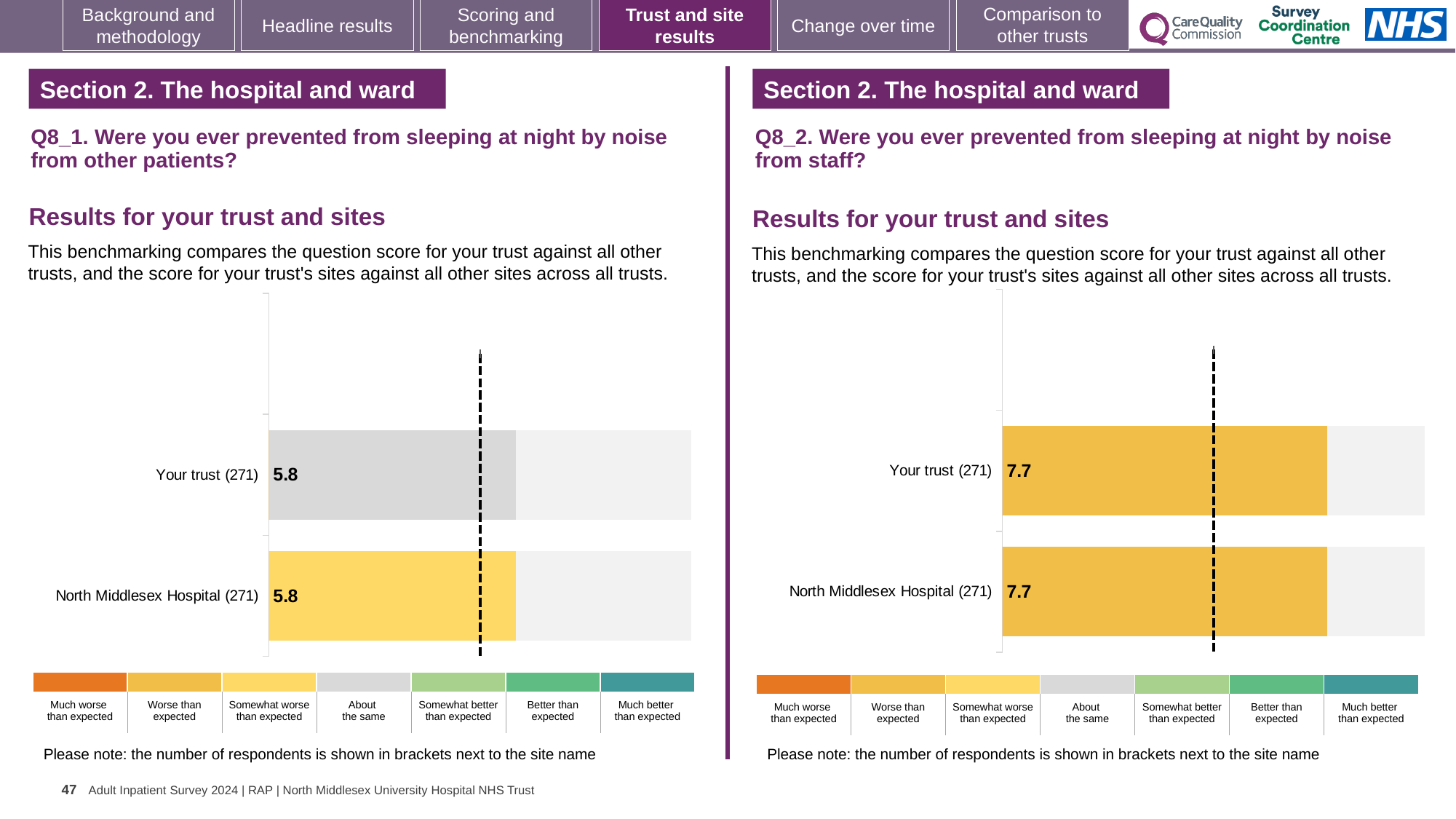
In the Q8_2 chart (noise from staff), what is the score for Your trust (271)? 7.7 How many bars are plotted in the Q8_1 chart (noise from other patients)? 2 How many categories does the colour legend below the Q8_1 chart list? 7 In the Q8_1 chart (noise from other patients), what is the difference between the score for Your trust and the score for North Middlesex Hospital? 0.0 In the Q8_1 chart (noise from other patients), which benchmark category does the colour of the Your trust bar correspond to? About the same What kind of chart is used for the Q8_2 results (noise from staff)? Bar chart How many respondents are shown in brackets for North Middlesex Hospital in the Q8_1 chart? 271 In the Q8_1 chart (noise from other patients), what is the score for North Middlesex Hospital (271)? 5.8 How many bars are plotted in the Q8_2 chart (noise from staff)? 2 In the Q8_1 chart (noise from other patients), what is the score for Your trust (271)? 5.8 In the Q8_2 chart (noise from staff), what is the difference between the score for Your trust and the score for North Middlesex Hospital? 0.0 In the Q8_2 chart (noise from staff), what is the score for North Middlesex Hospital (271)? 7.7